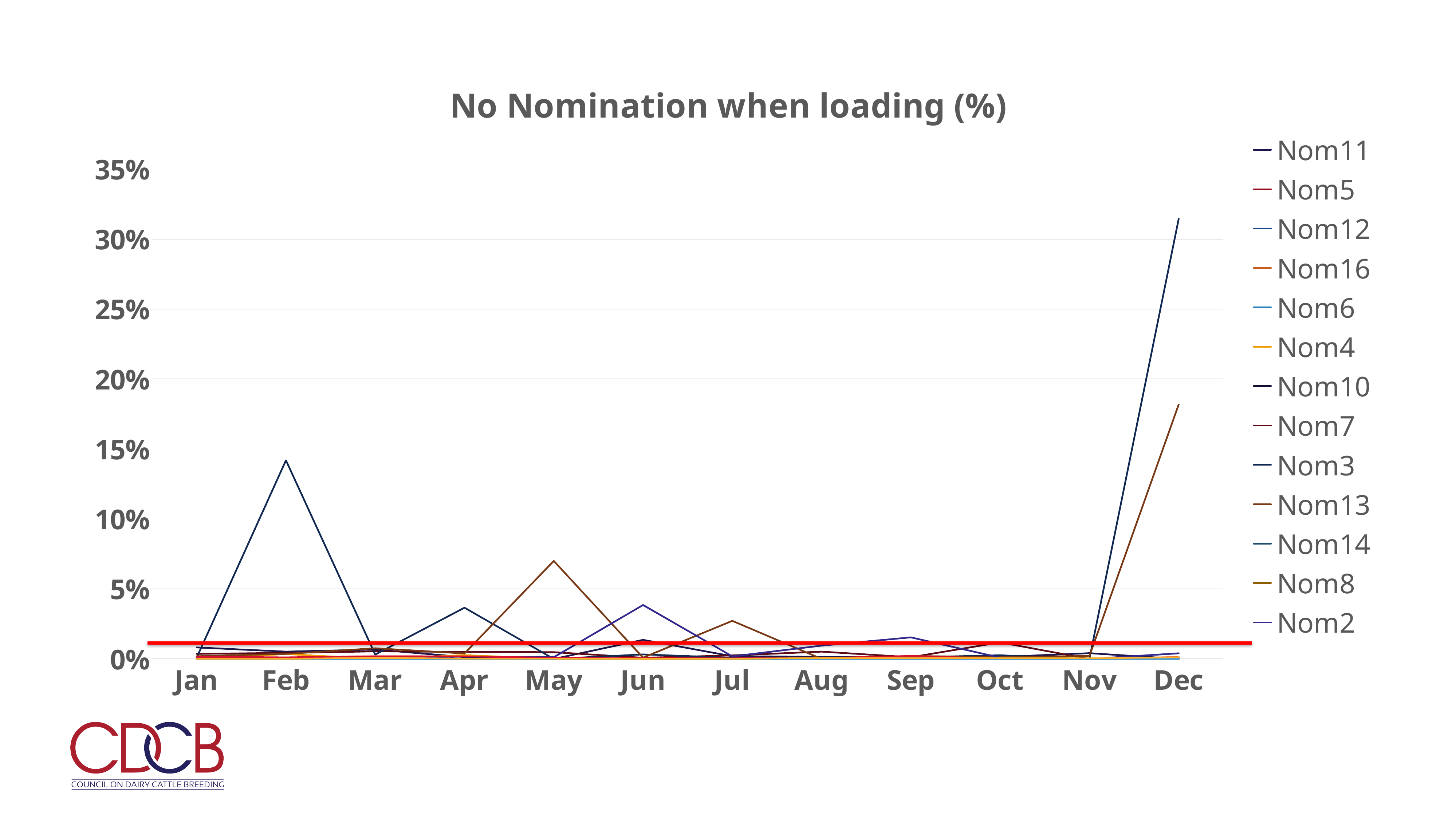
In which month does the highest value on the chart occur? Dec How many series does the legend list? 13 Is the highest value plotted in Feb greater or less than 15%? less Is the highest value plotted in May greater or less than 5%? greater What is the title of the chart? No Nomination when loading (%) Is the highest value plotted in Dec greater or less than 30%? greater What kind of chart is shown on the slide? Line chart Which month has the larger peak value, Feb or Dec? Dec How many months are shown along the x axis? 12 What is the highest value labelled on the y axis? 35%